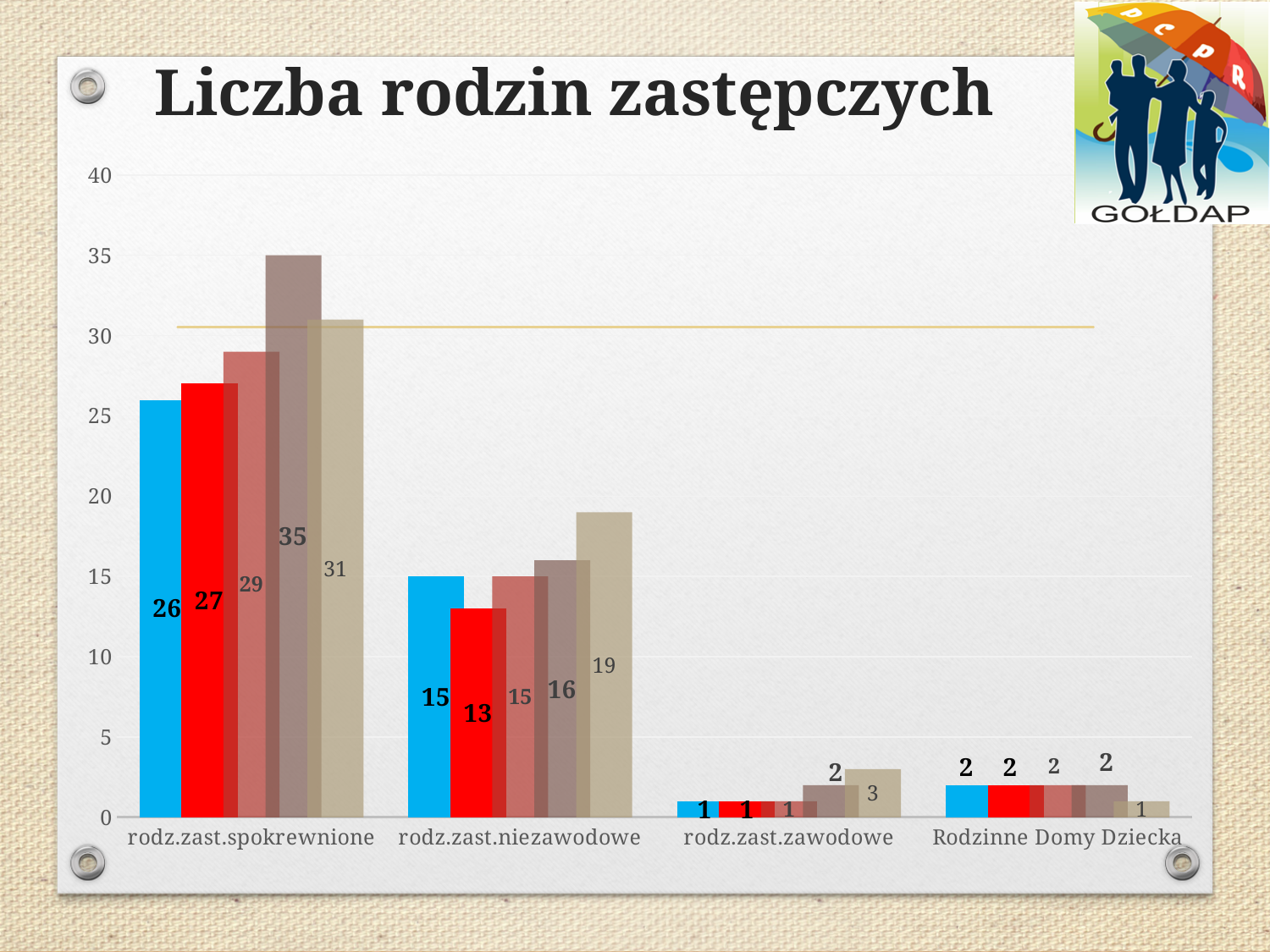
What kind of chart is shown on the slide? bar chart What is the value of the last (beige) bar for Rodzinne Domy Dziecka? 1 What is the lowest value among the bars for rodz.zast.niezawodowe? 13 How many categories are shown on the x axis of the chart? 4 How many bars are plotted for each category in the chart? 5 What is the title of the chart? Liczba rodzin zastępczych Which is larger: the blue bar for rodz.zast.spokrewnione or the blue bar for rodz.zast.niezawodowe? rodz.zast.spokrewnione What is the value of the tallest bar for rodz.zast.spokrewnione? 35 What is the difference between the fourth bar (35) and the first bar (26) for rodz.zast.spokrewnione? 9 What is the value of the last (beige) bar for rodz.zast.zawodowe? 3 Which category has the tallest bar in the chart? rodz.zast.spokrewnione What is the value of the first (blue) bar for rodz.zast.niezawodowe? 15